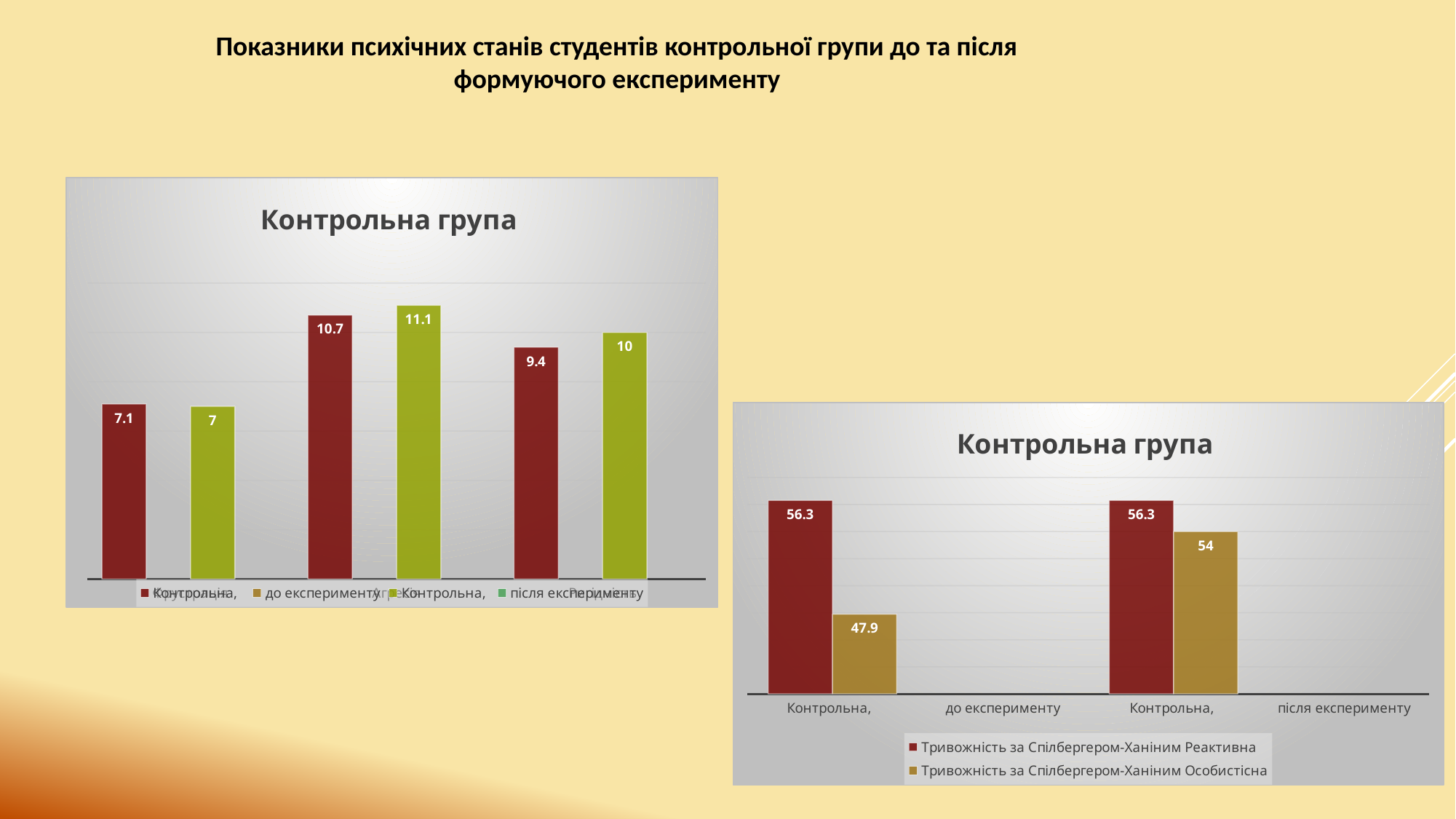
On the right chart, what is the value of 'Тривожність за Спілбергером-Ханіним Реактивна' for 'Контрольна, до експерименту'? 56.3 On the right chart, what is the value of 'Тривожність за Спілбергером-Ханіним Особистісна' for 'Контрольна, після експерименту'? 54 On the left chart, how many bars are plotted? 6 On the right chart, does the value of 'Тривожність за Спілбергером-Ханіним Реактивна' change between 'до експерименту' and 'після експерименту'? No, it stays at 56.3 On the right chart, which series has the larger value for 'Контрольна, після експерименту'? Тривожність за Спілбергером-Ханіним Реактивна On the right chart, how many series does the legend list? 2 On the left chart, what is the lowest value shown on a data label? 7 On the right chart, by how much does 'Тривожність за Спілбергером-Ханіним Особистісна' increase from 'до експерименту' to 'після експерименту'? 6.1 On the right chart, what is the value of 'Тривожність за Спілбергером-Ханіним Особистісна' for 'Контрольна, до експерименту'? 47.9 What type of chart is the left chart? Bar chart On the left chart, what is the highest value shown on a data label? 11.1 On the right chart, what is the difference between the two series for 'Контрольна, до експерименту'? 8.4